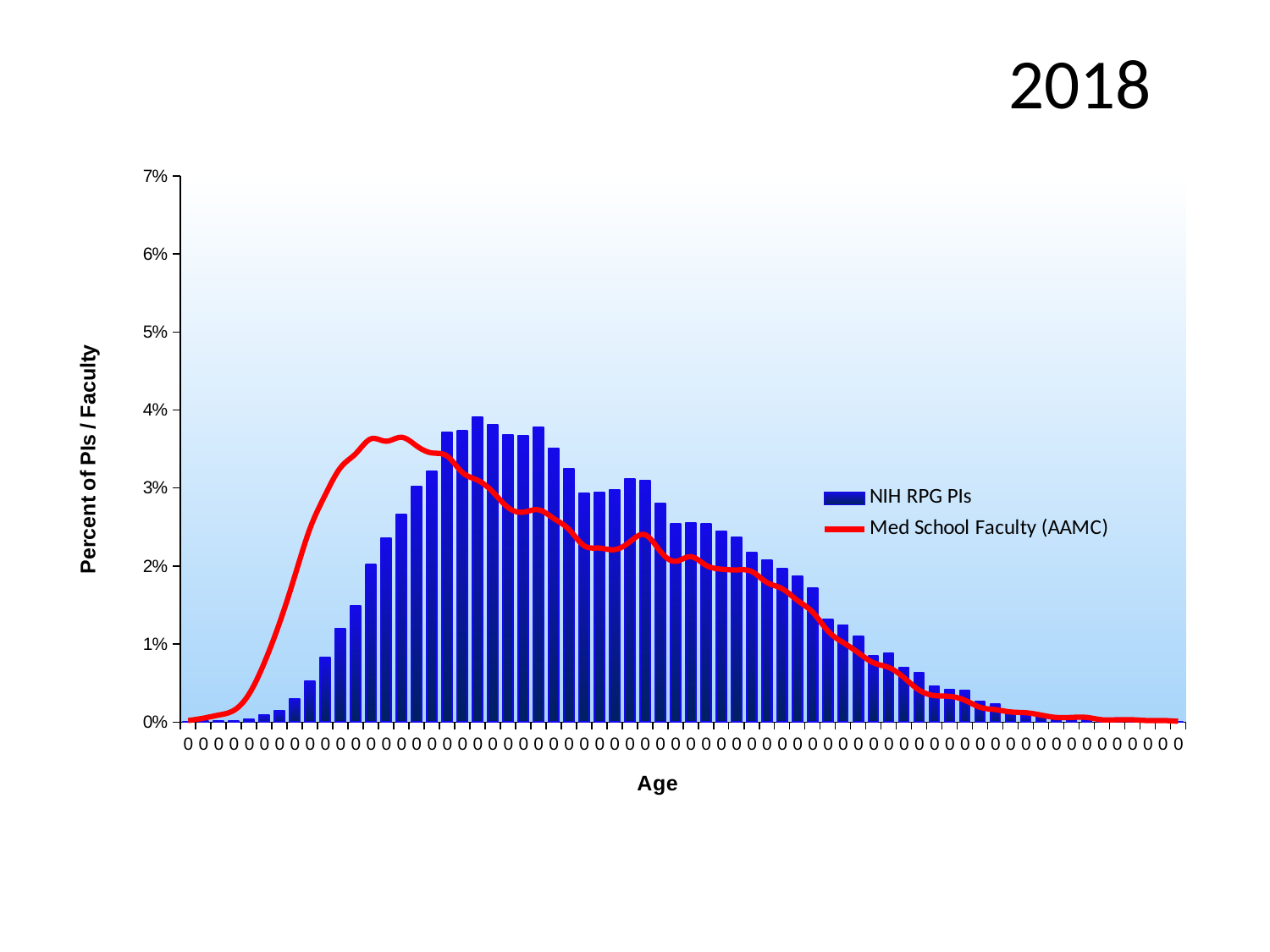
What kind of chart is used for the NIH RPG PIs series? bar chart Is the tallest NIH RPG PIs bar greater or less than 3%? greater How many series does the legend list? 2 Which series reaches its peak earlier along the Age axis, NIH RPG PIs or Med School Faculty (AAMC)? Med School Faculty (AAMC) What is the title of the vertical axis? Percent of PIs / Faculty What are the two series named in the legend? NIH RPG PIs and Med School Faculty (AAMC) Is the highest point of the Med School Faculty (AAMC) line greater or less than 4%? less Toward the right end of the Age axis, do the NIH RPG PIs values rise or fall? fall